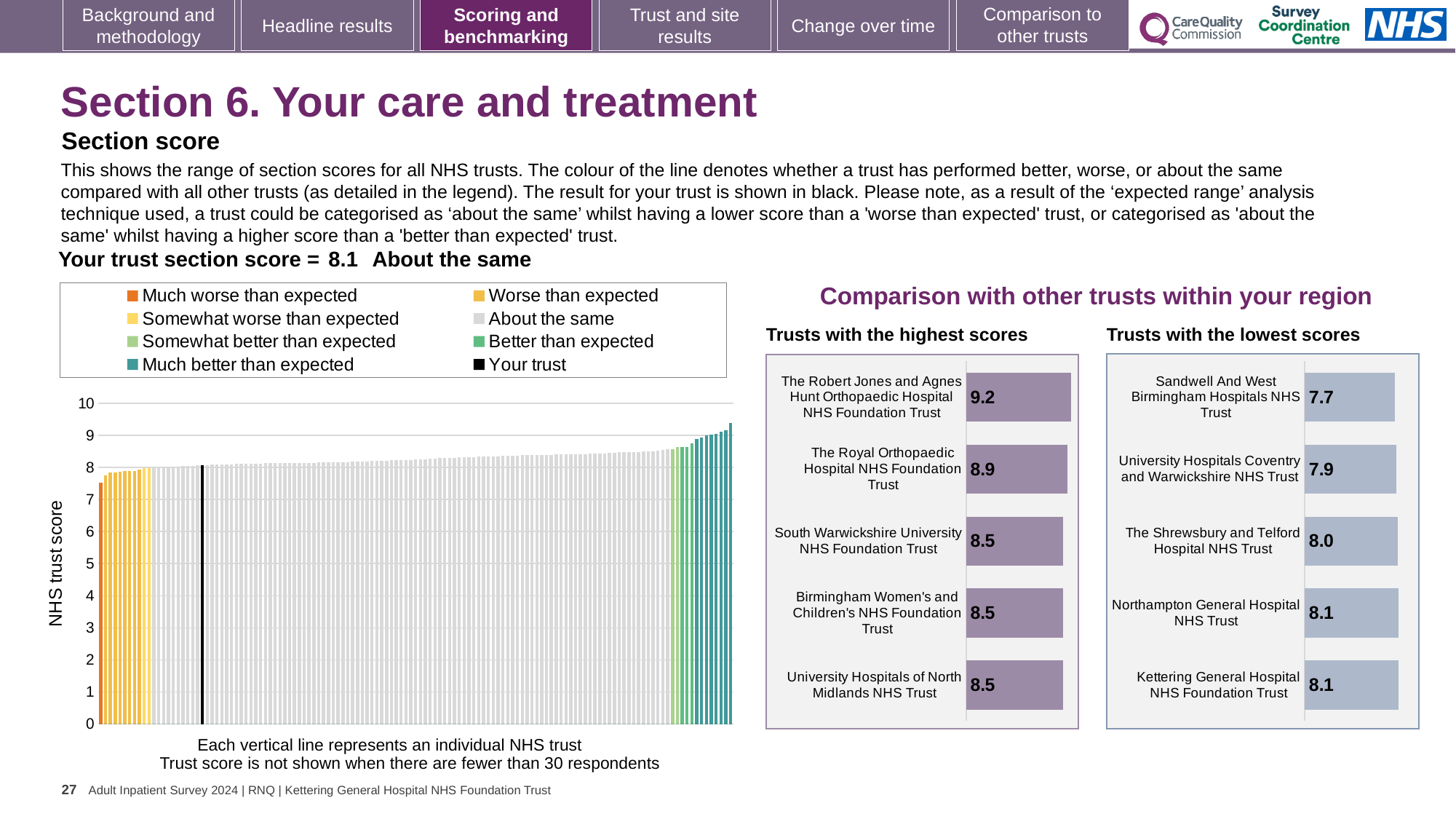
In the large chart on the left, do the trust scores rise or fall from left to right along the x axis? Rise In the 'Trusts with the lowest scores' chart, which has the larger score: The Shrewsbury and Telford Hospital NHS Trust or University Hospitals Coventry and Warwickshire NHS Trust? The Shrewsbury and Telford Hospital NHS Trust In the 'Trusts with the highest scores' chart, how many trusts are shown? 5 In the 'Trusts with the highest scores' chart, what is the score for The Robert Jones and Agnes Hunt Orthopaedic Hospital NHS Foundation Trust? 9.2 In the 'Trusts with the highest scores' chart, what is the difference between the scores of The Robert Jones and Agnes Hunt Orthopaedic Hospital NHS Foundation Trust and The Royal Orthopaedic Hospital NHS Foundation Trust? 0.3 In the 'Trusts with the lowest scores' chart, what is the difference between the scores of Kettering General Hospital NHS Foundation Trust and Sandwell And West Birmingham Hospitals NHS Trust? 0.4 In the 'Trusts with the highest scores' chart, which trust has the highest score? The Robert Jones and Agnes Hunt Orthopaedic Hospital NHS Foundation Trust In the 'Trusts with the lowest scores' chart, which trust has the lowest score? Sandwell And West Birmingham Hospitals NHS Trust What kind of chart is the large chart on the left showing NHS trust scores? Bar chart How many entries does the legend of the large chart on the left list? 8 In the 'Trusts with the lowest scores' chart, what is the score for Sandwell And West Birmingham Hospitals NHS Trust? 7.7 In the 'Trusts with the lowest scores' chart, what is the score for Northampton General Hospital NHS Trust? 8.1